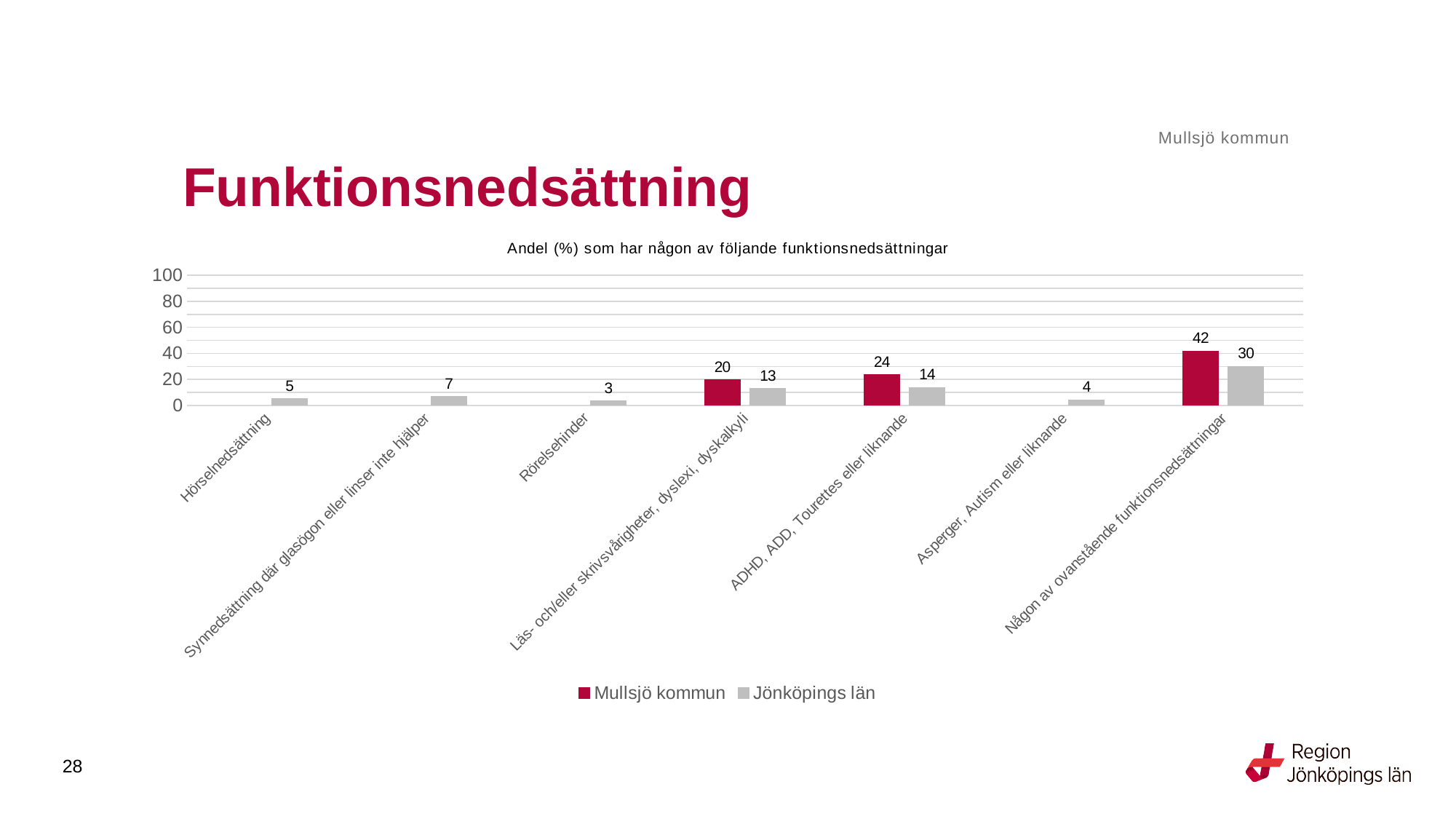
Which is larger for Läs- och/eller skrivsvårigheter, dyslexi, dyskalkyli: Mullsjö kommun or Jönköpings län? Mullsjö kommun What kind of chart is shown on the slide? Bar chart Is the value for Mullsjö kommun for Någon av ovanstående funktionsnedsättningar greater or less than 40? greater What is the value for Mullsjö kommun for ADHD, ADD, Tourettes eller liknande? 24 What is the value for Jönköpings län for Läs- och/eller skrivsvårigheter, dyslexi, dyskalkyli? 13 What is the value for Jönköpings län for Hörselnedsättning? 5 How many series does the legend list? 2 Which category has the highest value for Jönköpings län? Någon av ovanstående funktionsnedsättningar What is the difference between Mullsjö kommun and Jönköpings län for Någon av ovanstående funktionsnedsättningar? 12 How many categories are shown on the x axis? 7 What is the value for Mullsjö kommun for Någon av ovanstående funktionsnedsättningar? 42 Which category has the lowest value for Jönköpings län? Rörelsehinder